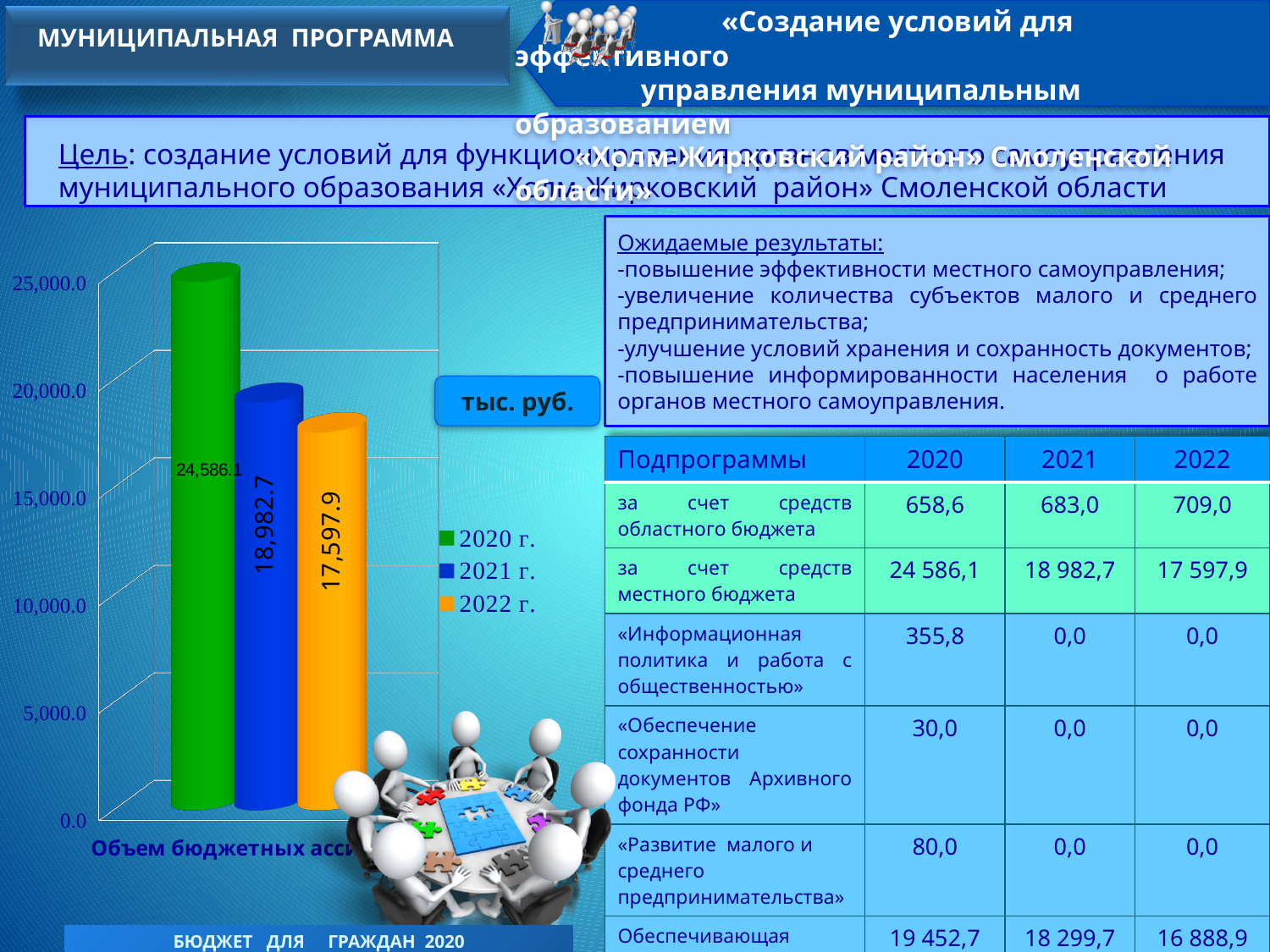
Which year has the highest bar in the chart? 2020 г. What is the difference between the 2021 г. and 2022 г. values in the chart? 1,384.8 Is the value for 2020 г. in the chart greater or less than 20,000.0? greater Which year has the lowest bar in the chart? 2022 г. How many series does the chart legend list? 3 What is the value of the 2022 г. bar in the chart? 17,597.9 Do the values in the chart rise or fall from 2020 г. to 2022 г.? fall What is the value of the 2021 г. bar in the chart? 18,982.7 What is the value of the 2020 г. bar in the chart? 24,586.1 What kind of chart is shown on the slide? bar chart Which is larger in the chart, the 2021 г. value or the 2022 г. value? 2021 г. What is the difference between the 2020 г. and 2021 г. values in the chart? 5,603.4